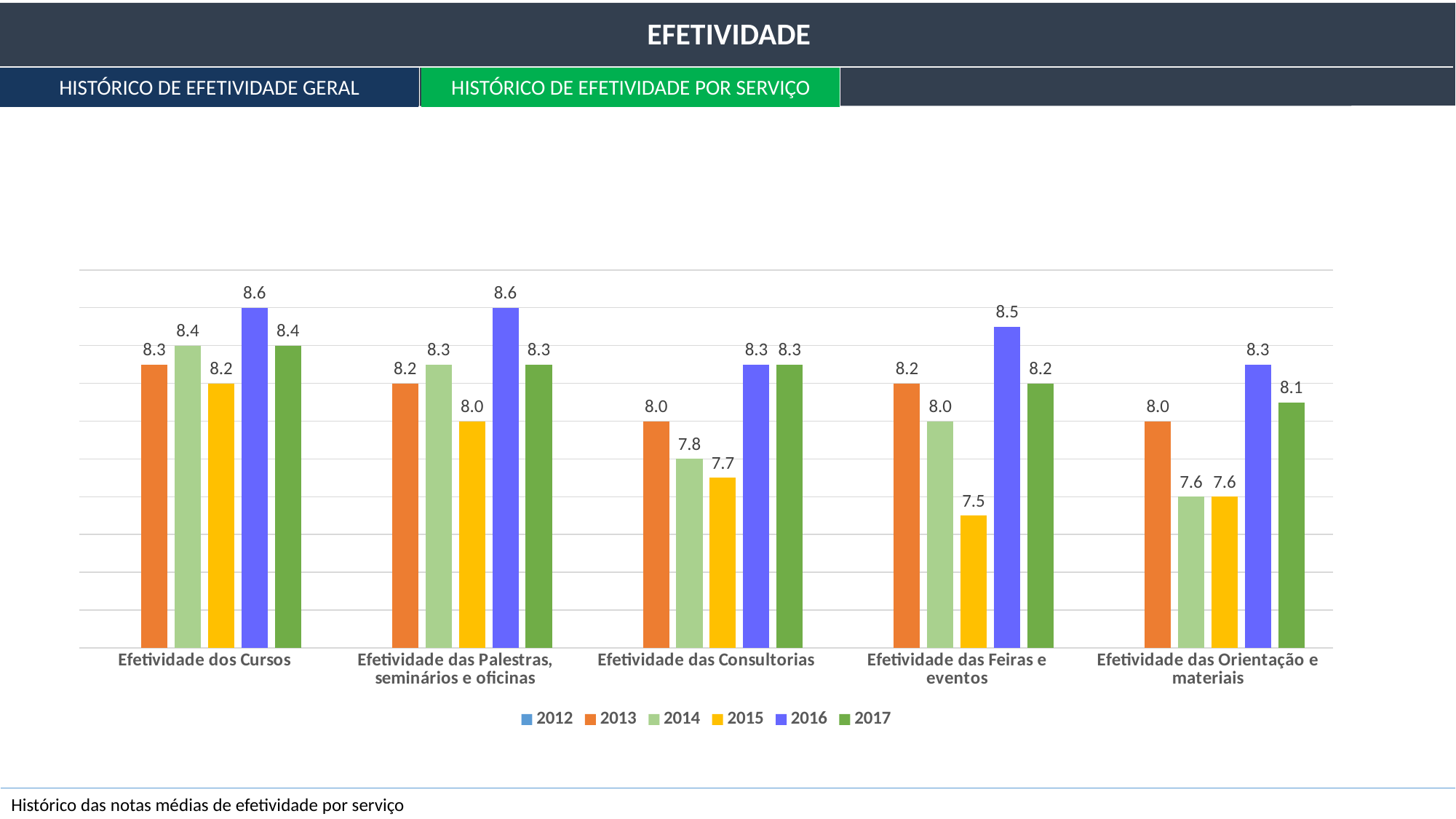
What is the 2017 value for Efetividade das Orientação e materiais? 8.1 Which is larger for Efetividade das Consultorias: the 2013 value or the 2015 value? 2013 Which category has the highest 2015 value? Efetividade dos Cursos What kind of chart is shown on the slide? Bar chart Which legend entry has no visible bars in the chart? 2012 What is the 2015 value for Efetividade das Feiras e eventos? 7.5 Which category has the lowest 2016 value? Efetividade das Consultorias and Efetividade das Orientação e materiais (both 8.3) What is the difference between the 2016 and 2015 values for Efetividade das Feiras e eventos? 1.0 What is the 2016 value for Efetividade dos Cursos? 8.6 How many service categories are shown on the x axis? 5 How many series does the legend list? 6 What is the 2014 value for Efetividade das Consultorias? 7.8